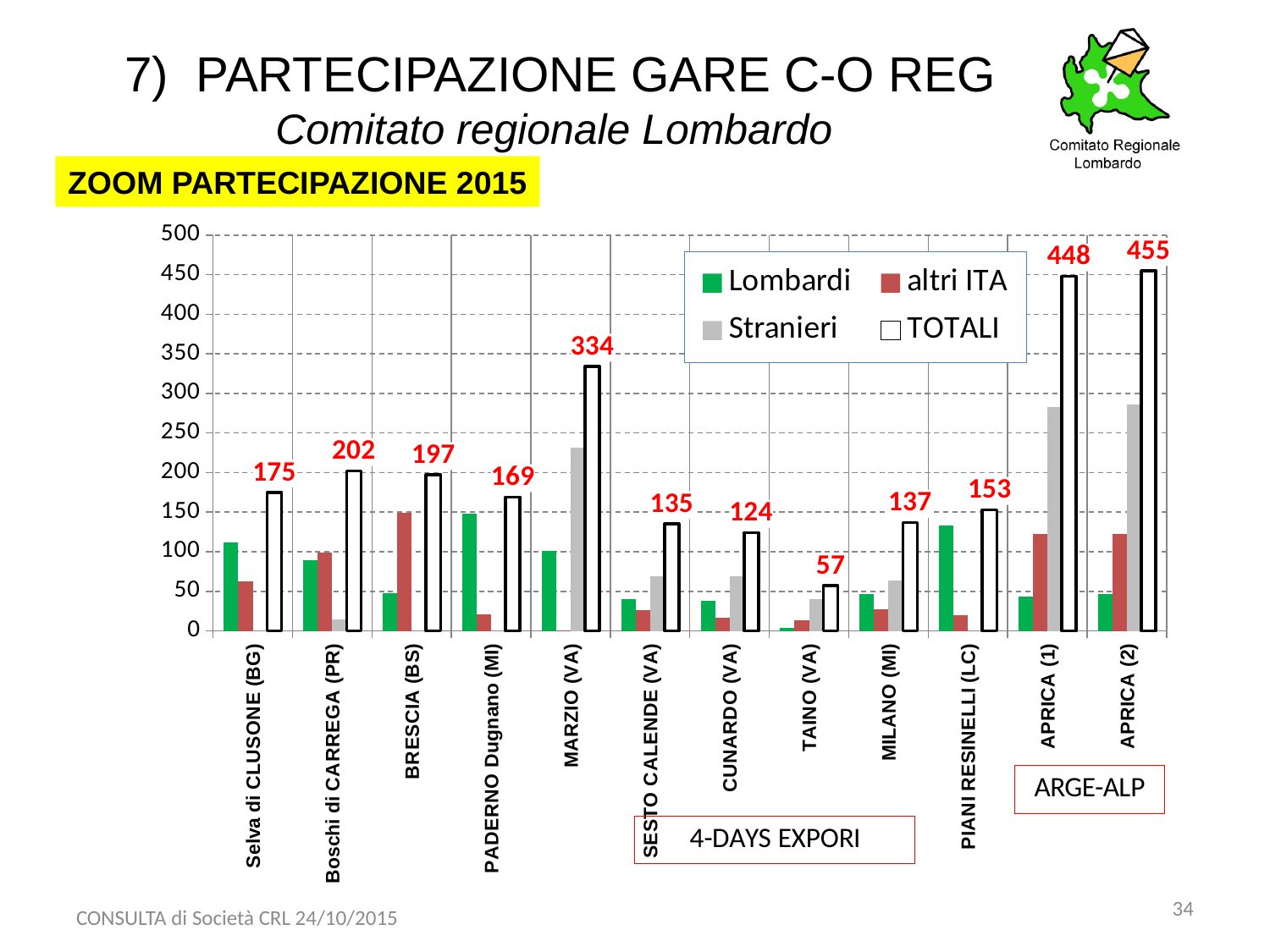
Is the Stranieri value for APRICA (1) greater or less than 250? greater What is the TOTALI value for Boschi di CARREGA (PR)? 202 What kind of chart is shown on the slide? Bar chart Which category has the highest TOTALI value? APRICA (2) Which has a larger TOTALI value, BRESCIA (BS) or PADERNO Dugnano (MI)? BRESCIA (BS) How many categories are shown on the x axis of the chart? 12 How many series does the legend list? 4 Which category has the lowest TOTALI value? TAINO (VA) What is the difference between the TOTALI values for APRICA (2) and APRICA (1)? 7 What is the TOTALI value for TAINO (VA)? 57 Is the Lombardi value for TAINO (VA) greater or less than 50? less What is the TOTALI value for MARZIO (VA)? 334